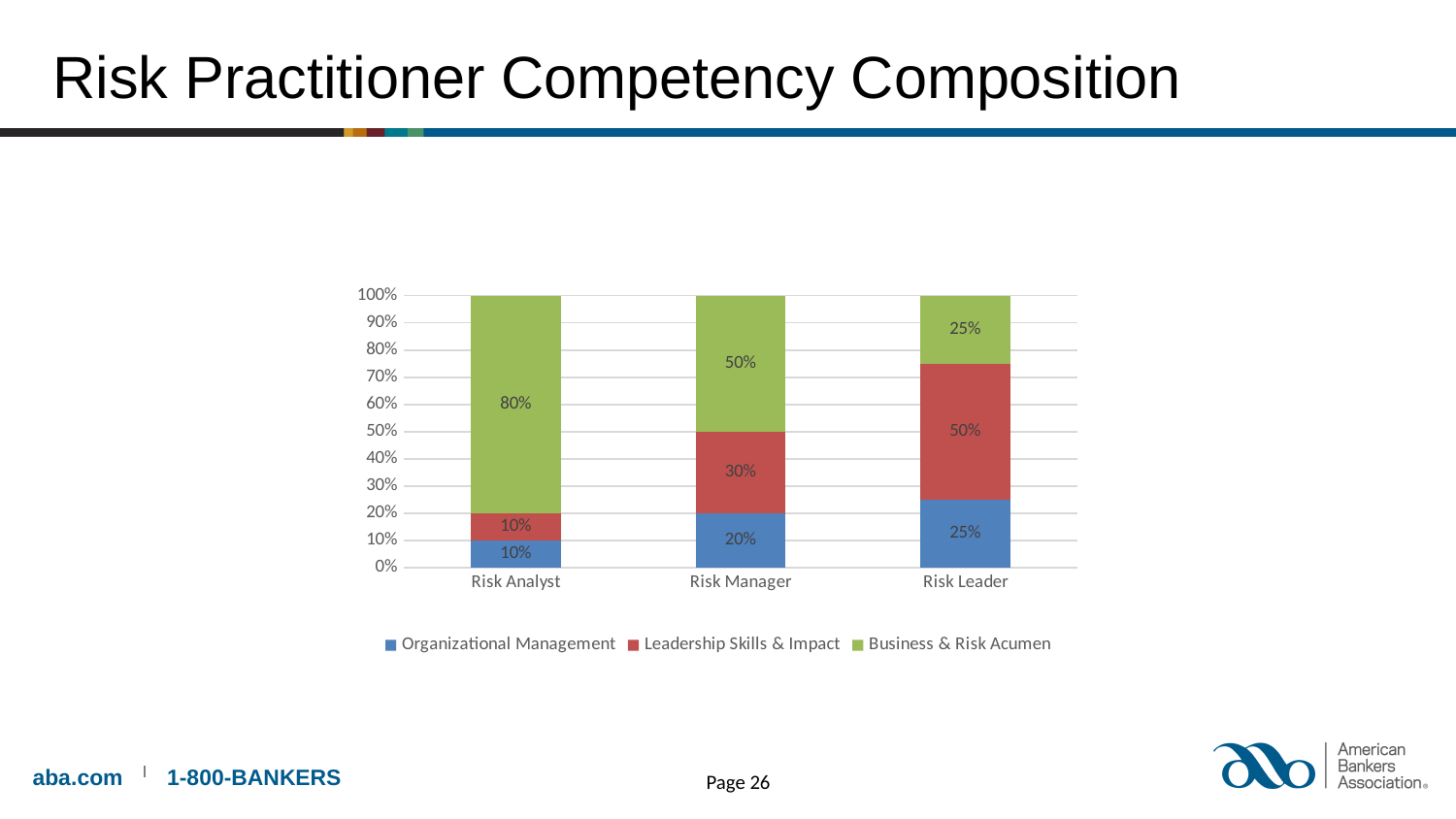
How many series does the legend list? 3 Which category has the highest Business & Risk Acumen value? Risk Analyst What kind of chart is shown on the slide? Stacked bar chart What is the difference between the Leadership Skills & Impact values for Risk Leader and Risk Analyst? 40% How many categories are shown on the x axis? 3 Which is larger: the Organizational Management value for Risk Manager or for Risk Leader? Risk Leader What is the Business & Risk Acumen value for Risk Leader? 25% Does the Business & Risk Acumen value rise or fall from Risk Analyst to Risk Leader? Fall What is the Organizational Management value for Risk Leader? 25% What is the Business & Risk Acumen value for Risk Analyst? 80% What is the Leadership Skills & Impact value for Risk Manager? 30% Which category has the lowest Organizational Management value? Risk Analyst